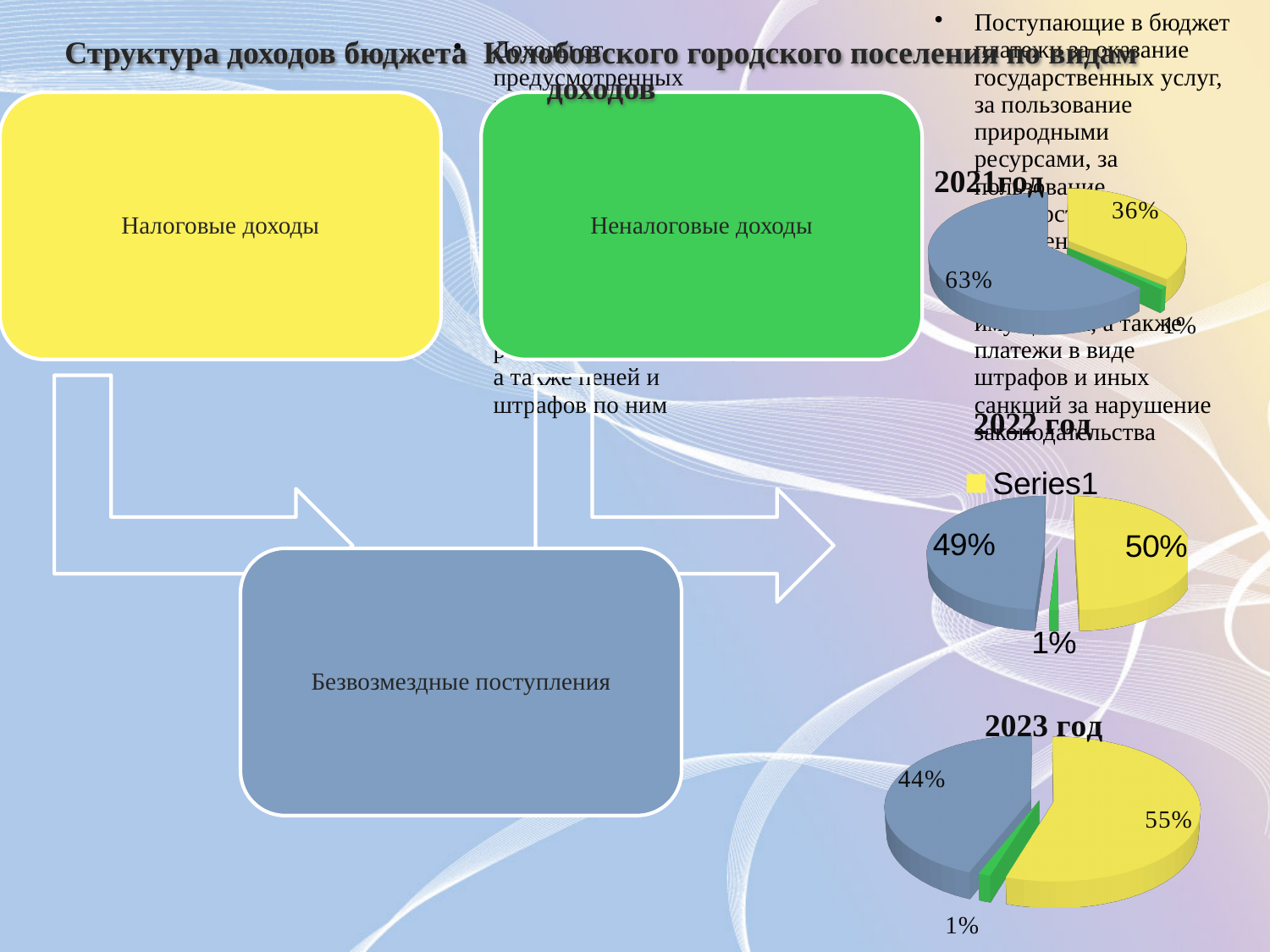
In the 2022 год pie chart, what percentage is shown for the green slice? 1% In the 2021 год pie chart, what percentage is shown for the yellow slice? 36% In the 2023 год pie chart, which slice is the smallest? the green slice (1%) How many slices does the 2023 год pie chart have? 3 What legend entry is shown above the 2022 год pie chart? Series1 In the 2022 год pie chart, what percentage is shown for the yellow slice? 50% In the 2022 год pie chart, what is the difference between the yellow slice and the blue slice? 1% In the 2021 год pie chart, what percentage is shown for the blue slice? 63% In the 2023 год pie chart, what percentage is shown for the blue slice? 44% In the 2021 год pie chart, which slice is the largest? the blue slice (63%) What kind of chart is used for the 2021 год chart? pie chart In the 2023 год pie chart, what percentage is shown for the yellow slice? 55%